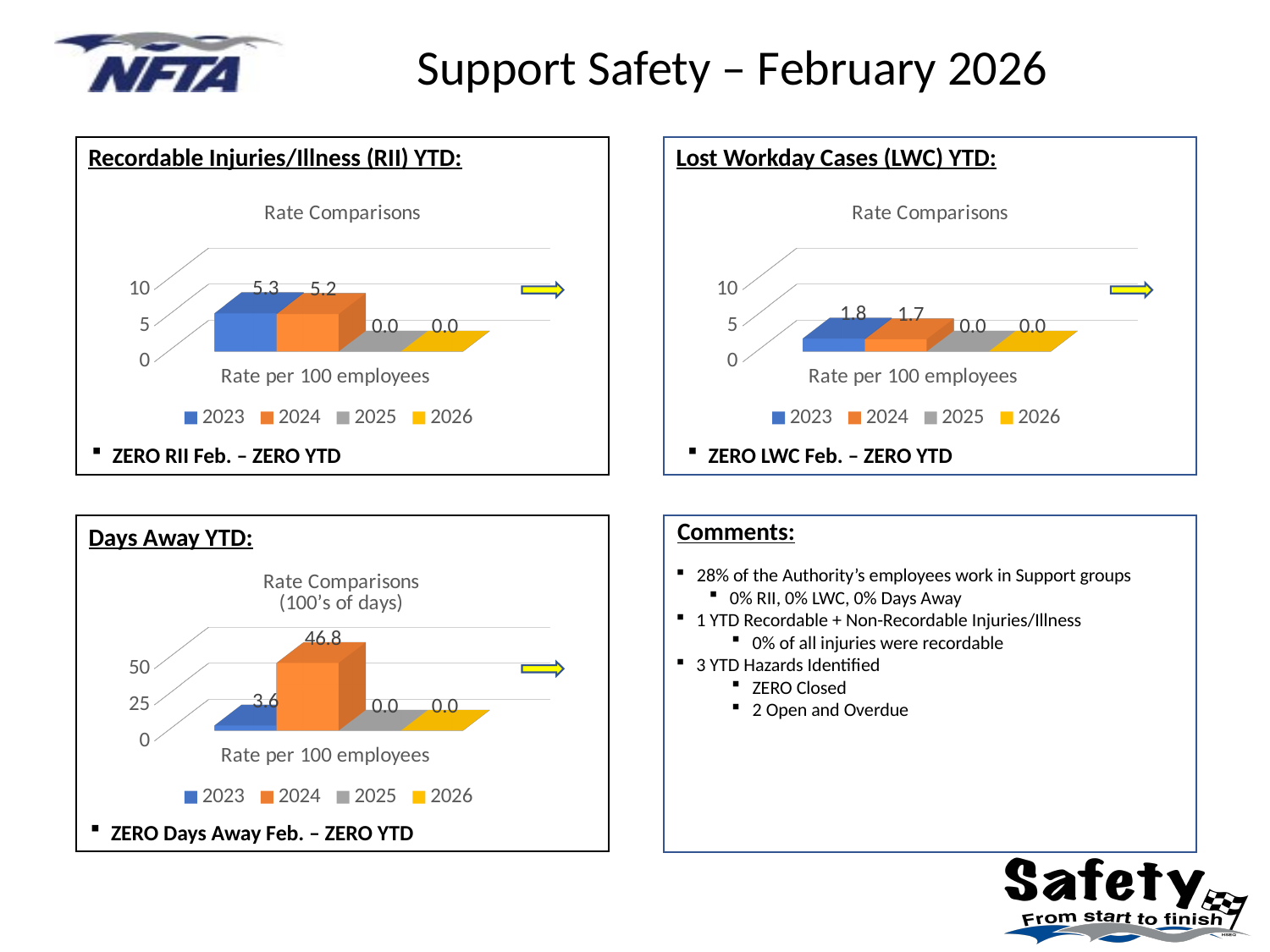
In the Recordable Injuries/Illness (RII) YTD chart, what is the difference between the 2023 and 2024 values? 0.1 In the Recordable Injuries/Illness (RII) YTD chart, what is the value for 2024? 5.2 How many series does the legend list in the Recordable Injuries/Illness (RII) YTD chart? 4 In the Days Away YTD chart, which year has the highest value? 2024 In the Lost Workday Cases (LWC) YTD chart, which year has the highest value? 2023 In the Days Away YTD chart, what is the difference between the 2024 and 2023 values? 43.2 In the Lost Workday Cases (LWC) YTD chart, what is the value for 2026? 0.0 In the Days Away YTD chart, what is the value for 2023? 3.6 In the Days Away YTD chart, what is the value for 2024? 46.8 In the Lost Workday Cases (LWC) YTD chart, what is the value for 2023? 1.8 In the Recordable Injuries/Illness (RII) YTD chart, what is the value for 2023? 5.3 What kind of chart is the Days Away YTD chart? Bar chart